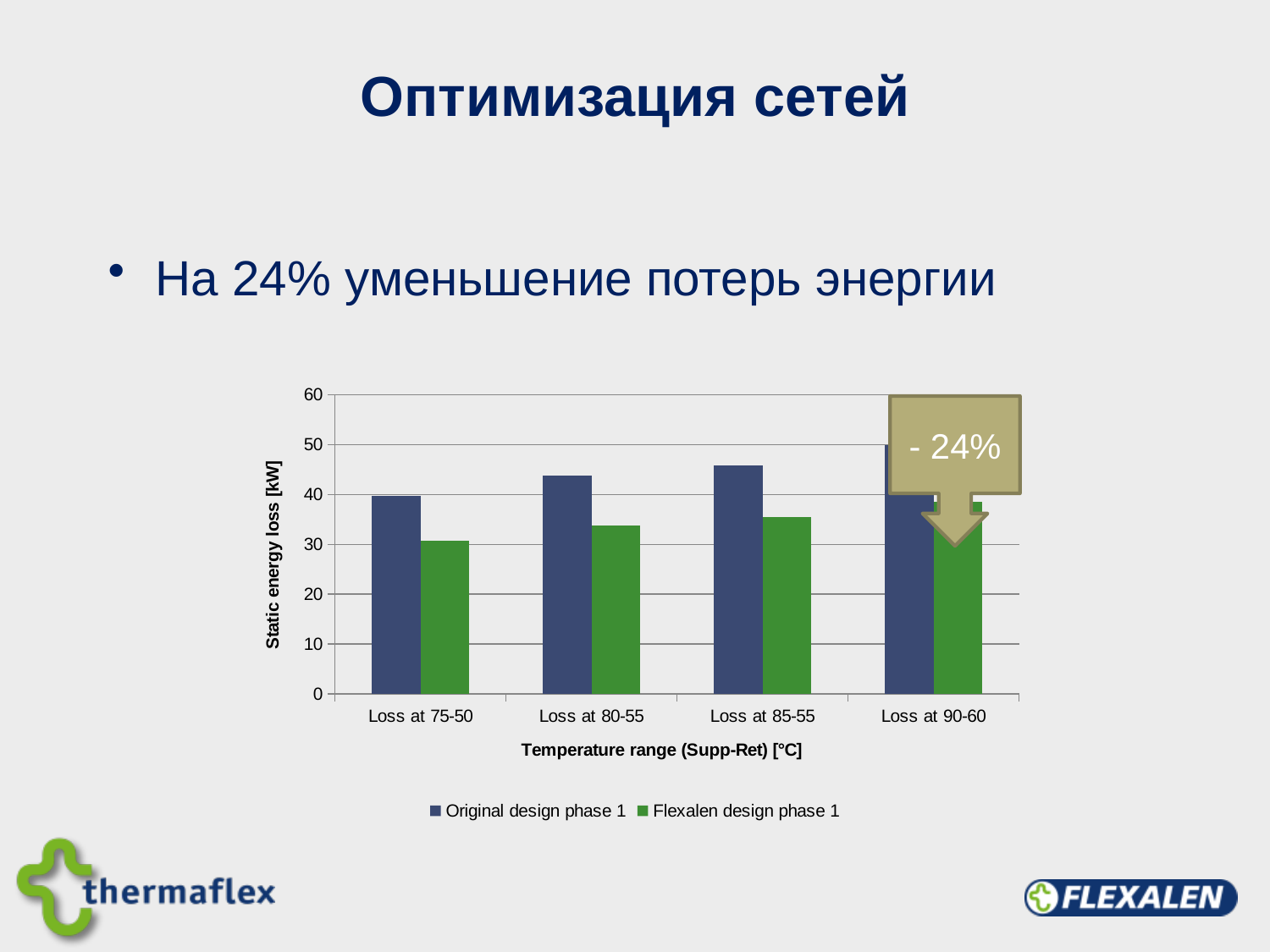
Is the value for Original design phase 1 at Loss at 80-55 greater or less than 40? greater What kind of chart is shown on the slide? bar chart How many series does the legend list? 2 What is the label of the y axis? Static energy loss [kW] Do the values for Flexalen design phase 1 rise or fall as the temperature range increases along the x axis? rise Which temperature range has the highest value for Original design phase 1? Loss at 90-60 Which temperature range has the lowest value for Flexalen design phase 1? Loss at 75-50 How many temperature range categories are shown on the x axis? 4 At Loss at 85-55, which series has the larger value, Original design phase 1 or Flexalen design phase 1? Original design phase 1 Is the value for Flexalen design phase 1 at Loss at 85-55 greater or less than 40? less What percentage is shown in the arrow annotation on the chart? - 24% Is the value for Flexalen design phase 1 at Loss at 80-55 greater or less than 30? greater